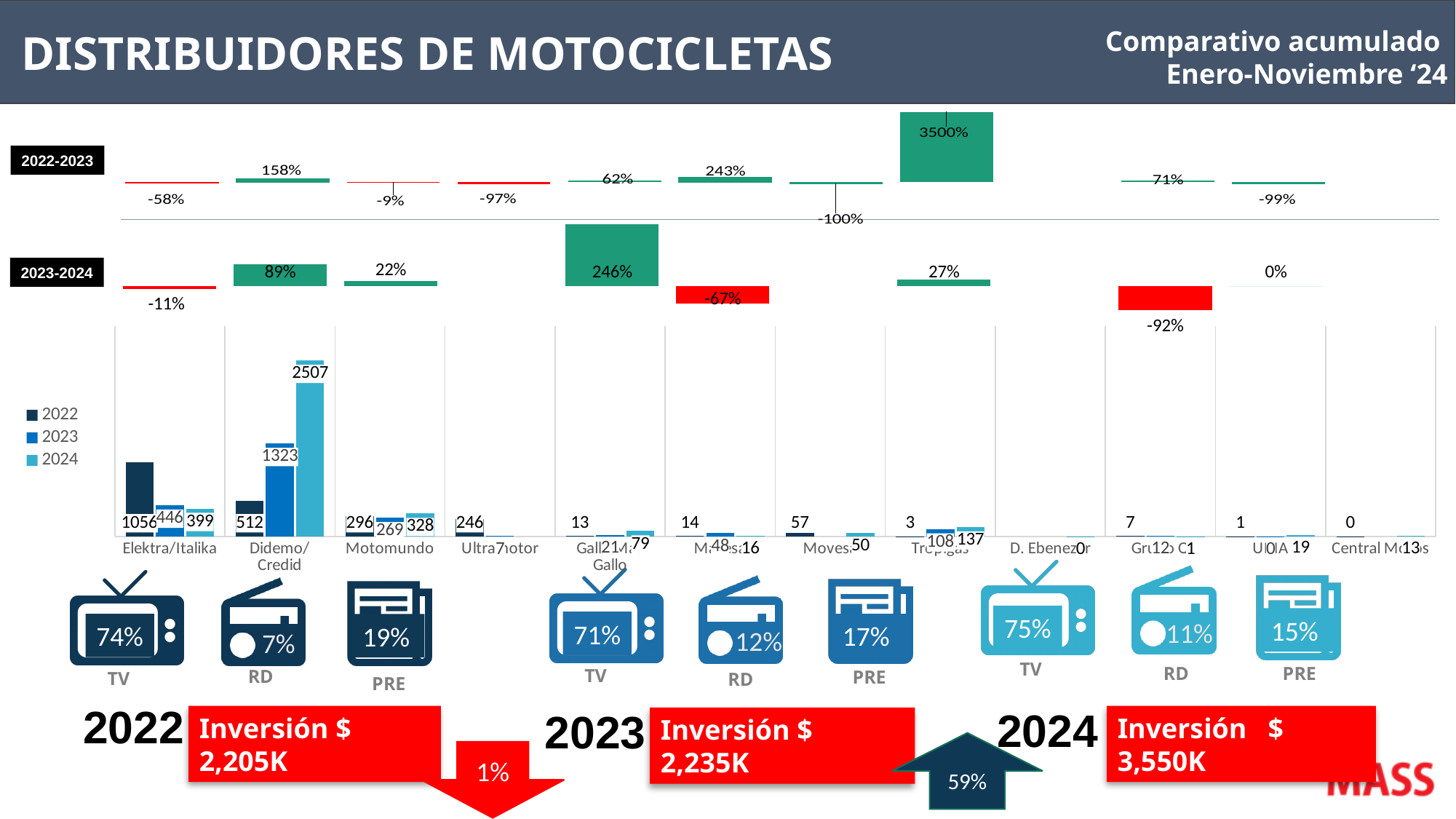
In the bar chart, which is larger: the 2022 value for Elektra/Italika or the 2022 value for Didemo/Credid? Elektra/Italika In the bar chart, what is the value for Elektra/Italika in 2022? 1056 In the bar chart, what is the difference between the 2022 and 2024 values for Elektra/Italika? 657 In the bar chart, do the values for Didemo/Credid rise or fall from 2022 to 2024? rise How many series does the legend of the bar chart list? 3 In the bar chart, what is the value for Motomundo in 2024? 328 What kind of chart is the main chart showing distributor values by year? bar chart In the 2022-2023 percentage chart, what is the highest percentage shown? 3500% In the bar chart, what is the value for Tropigas in 2024? 137 In the bar chart, what is the difference between the 2024 and 2023 values for Didemo/Credid? 1184 In the bar chart, what is the value for Didemo/Credid in 2024? 2507 In the bar chart, which distributor has the highest 2024 value? Didemo/Credid